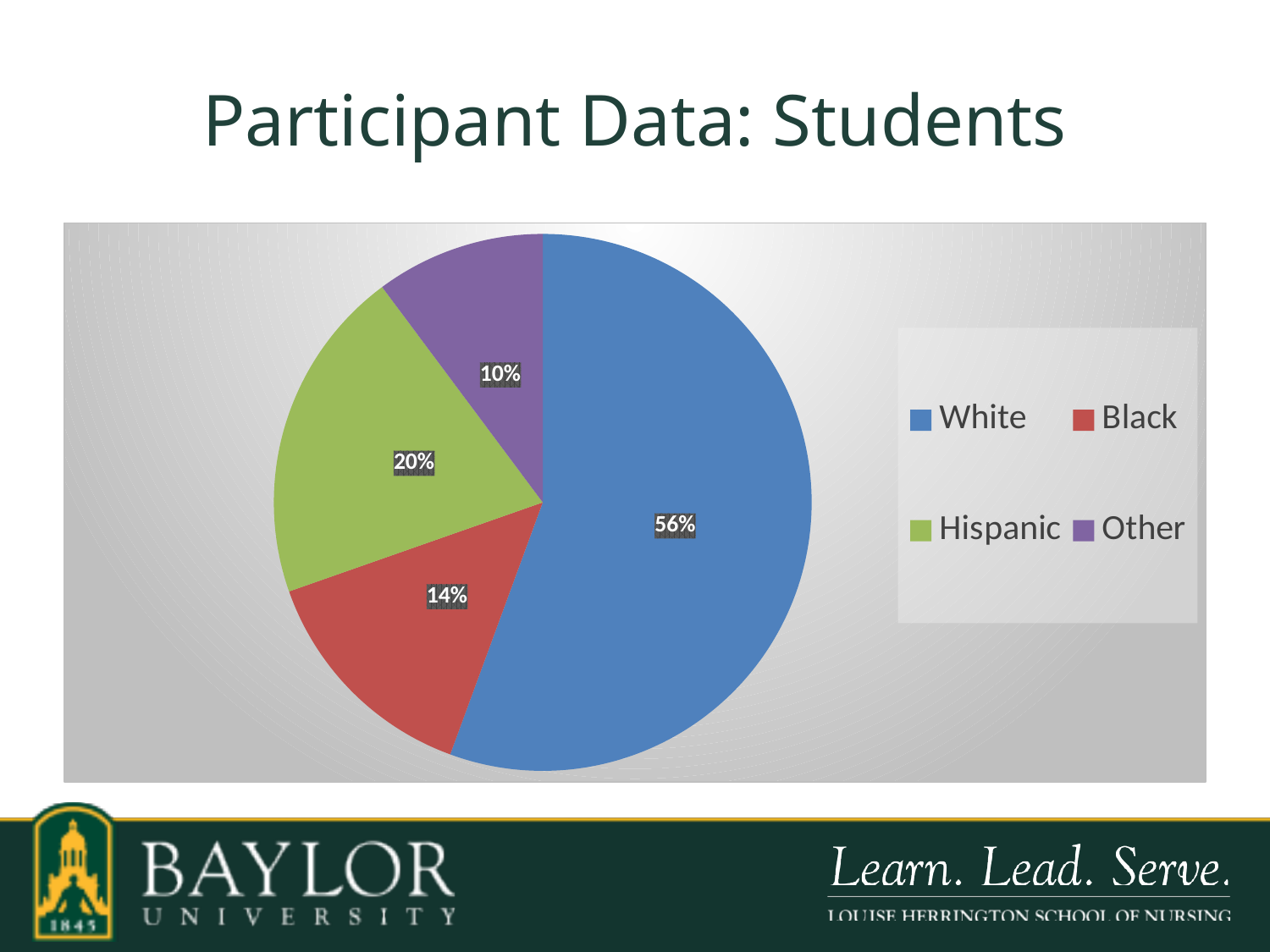
What is the difference in percentage points between the White and Hispanic slices? 36 What is the title of the slide containing the chart? Participant Data: Students Which category has the smallest slice of the pie? Other How many categories does the pie chart show? 4 What share of the pie does the White slice represent? 56% What share of the pie does the Other slice represent? 10% Which category has the largest slice of the pie? White What kind of chart is shown on the slide? pie chart What colour is the Hispanic slice in the pie chart? green What share of the pie does the Black slice represent? 14% Which slice is larger, Black or Hispanic? Hispanic